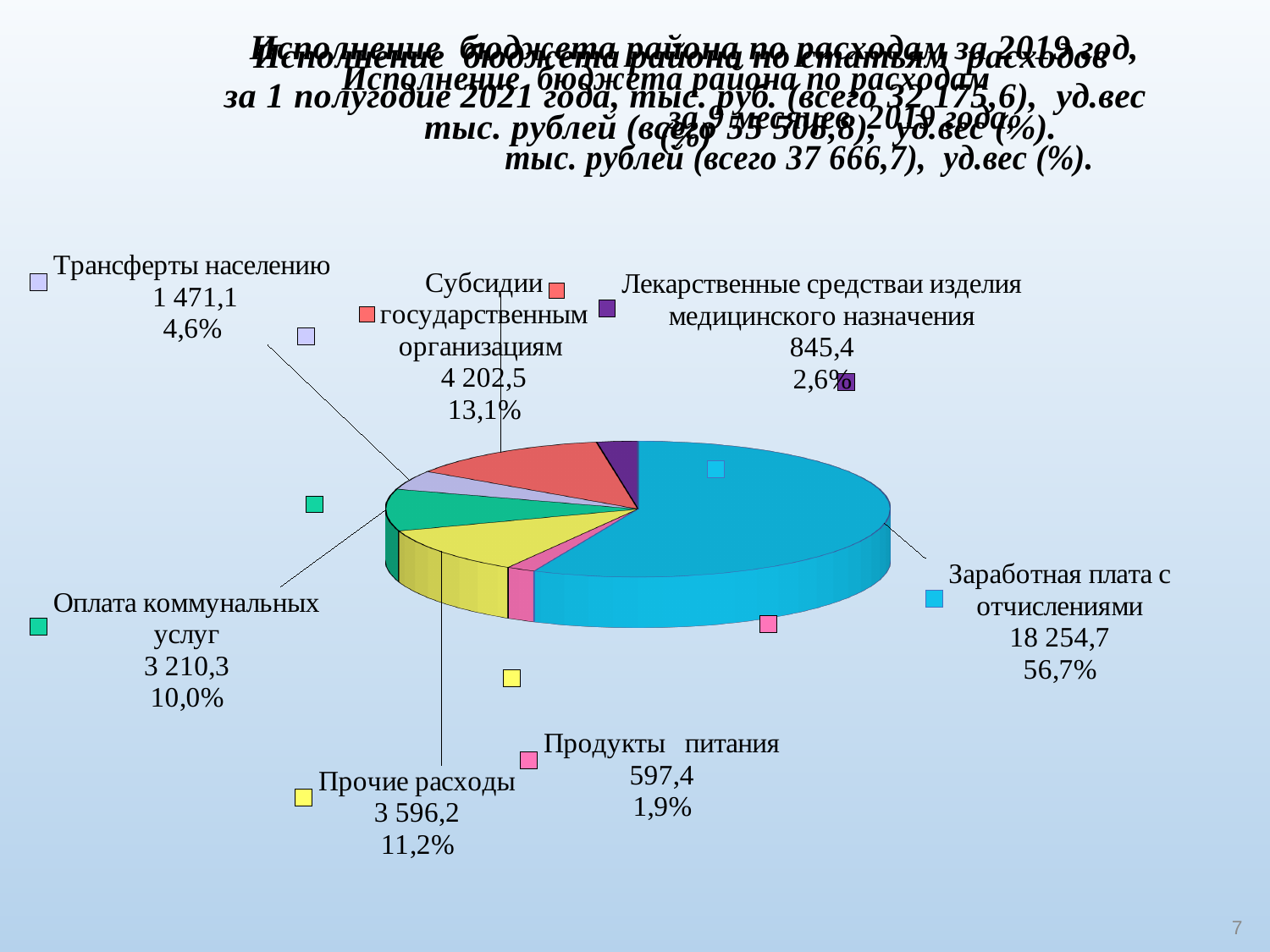
Which category has the largest slice of the pie? Заработная плата с отчислениями How many categories (slices) does the pie chart show? 7 What share of the pie does Оплата коммунальных услуг represent? 10,0% What is the difference between the values for Трансферты населению and Лекарственные средства и изделия медицинского назначения? 625,7 What is the value shown for Субсидии государственным организациям? 4 202,5 Which category has the smallest slice of the pie? Продукты питания What is the value shown for Продукты питания? 597,4 What is the value shown for Заработная плата с отчислениями? 18 254,7 What is the difference between the values for Субсидии государственным организациям and Прочие расходы? 606,3 What kind of chart is shown on the slide? Pie chart Which is larger: Прочие расходы or Оплата коммунальных услуг? Прочие расходы What share of the pie does Заработная плата с отчислениями represent? 56,7%